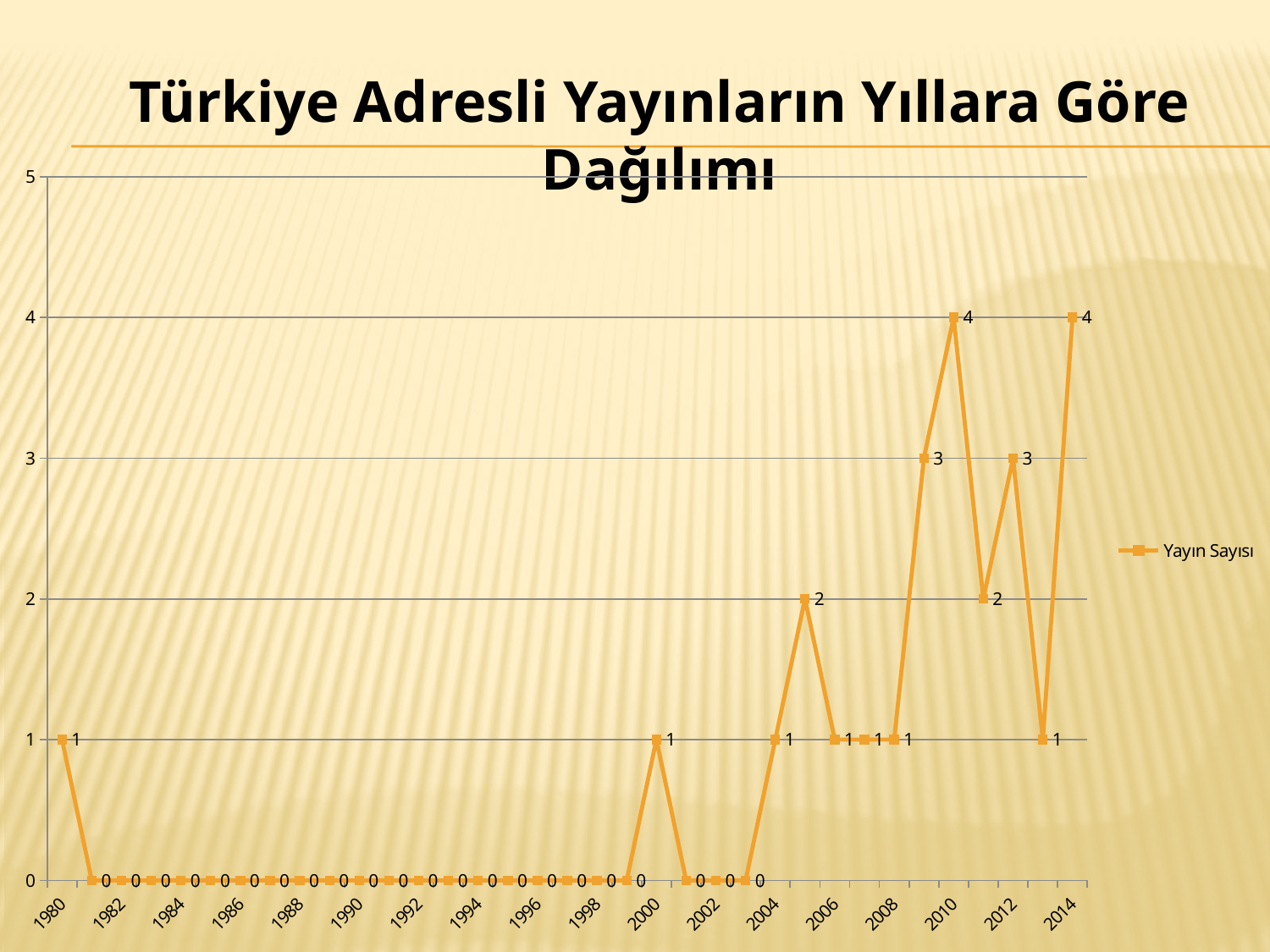
Is the value for 2014 greater or less than 3? greater What is the difference between the values for 2010 and 2011? 2 What is the value for 1980? 1 Which year has the larger value, 2012 or 2013? 2012 How many series does the legend list? 1 What is the value for 2005? 2 What type of chart is shown on the slide? line chart What is the value for 2013? 1 What is the value for 2009? 3 What is the value for 2010? 4 What is the name of the series shown in the legend? Yayın Sayısı What is the highest value plotted on the chart? 4